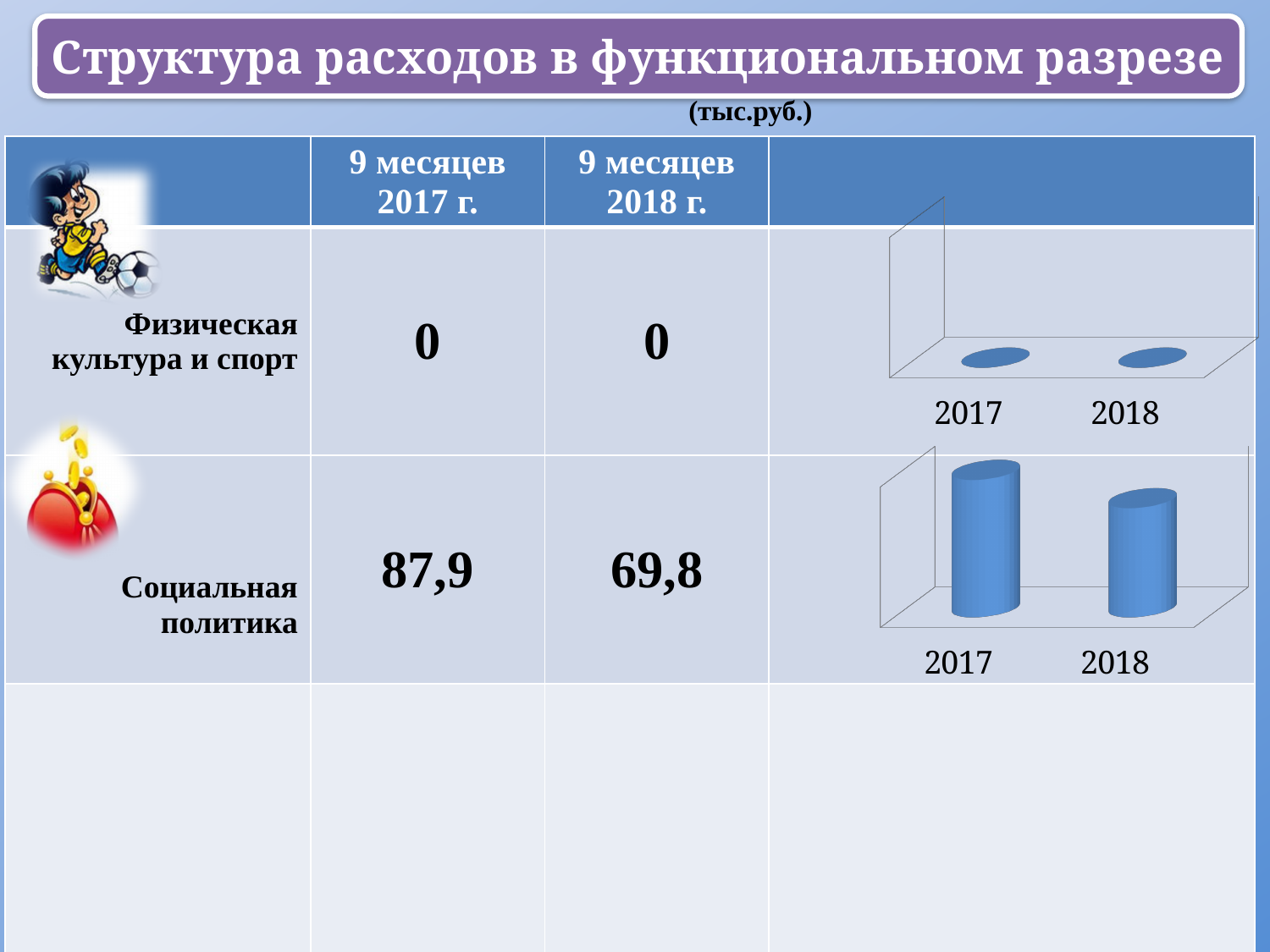
In the chart next to the 'Социальная политика' row, what is the value for 2018? 69,8 In the chart next to the 'Физическая культура и спорт' row, what is the value for 2018? 0 In the chart next to the 'Физическая культура и спорт' row, what is the value for 2017? 0 In the chart next to the 'Социальная политика' row, which year has the lower bar? 2018 In the chart next to the 'Социальная политика' row, which year has the higher bar? 2017 In the chart next to the 'Социальная политика' row, do the values rise or fall from 2017 to 2018? fall In the chart next to the 'Социальная политика' row, is the value for 2017 larger or smaller than the value for 2018? larger How many categories are shown on the x axis of the chart next to the 'Социальная политика' row? 2 In the chart next to the 'Социальная политика' row, what is the difference between the 2017 and 2018 values? 18,1 In the chart next to the 'Социальная политика' row, what is the value for 2017? 87,9 What is the title of the slide containing the charts? Структура расходов в функциональном разрезе What kind of chart is shown next to the 'Социальная политика' row? bar chart